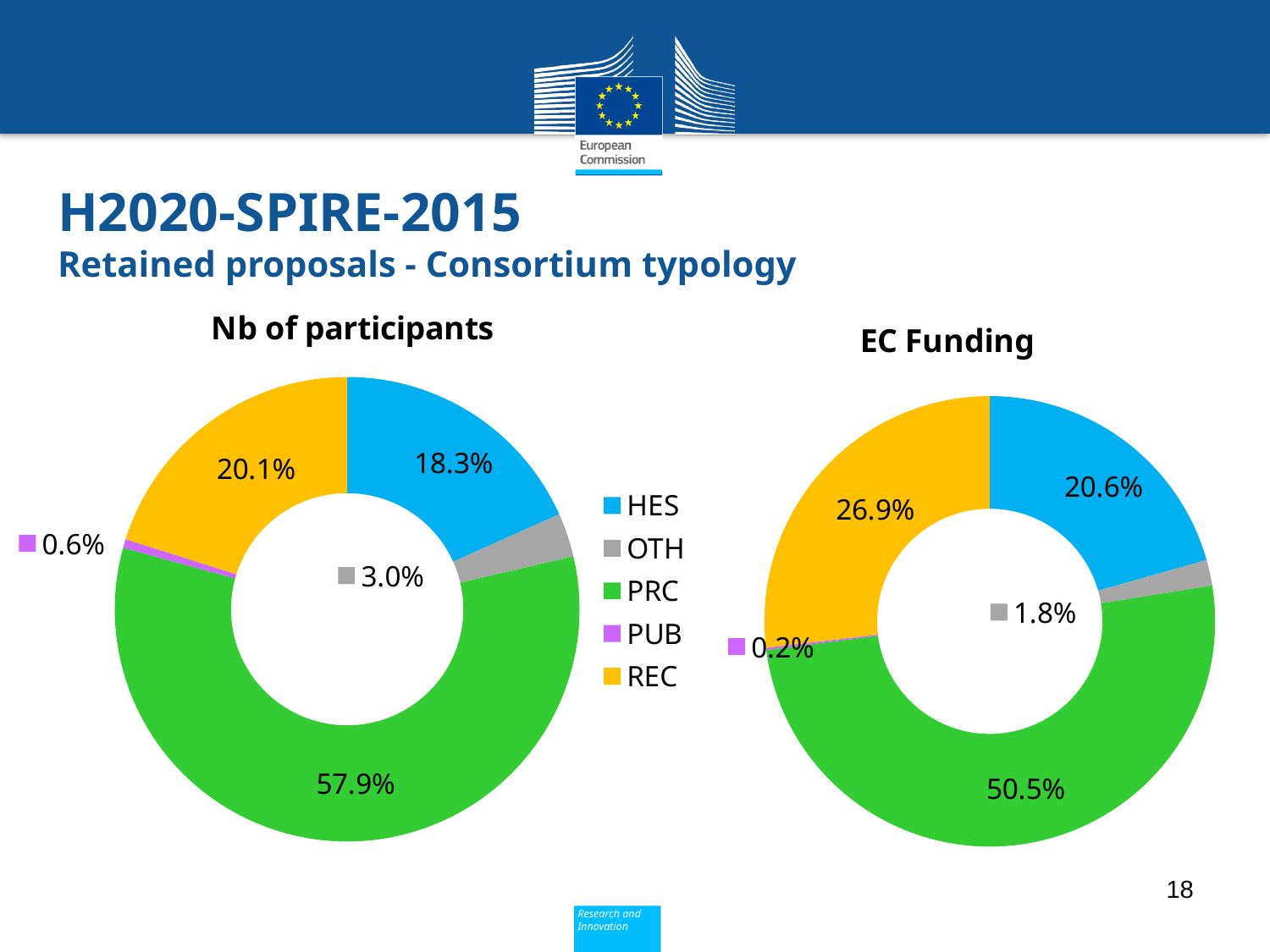
In the 'Nb of participants' chart, which category has the largest share? PRC How many categories does the legend list? 5 What kind of chart is the 'EC Funding' chart? doughnut (pie) chart In the 'EC Funding' chart, which category has the smallest share? PUB In the 'Nb of participants' chart, what is the share for PRC? 57.9% In the 'EC Funding' chart, what is the share for HES? 20.6% Which colour represents PRC in the legend? green In the 'EC Funding' chart, what is the share for REC? 26.9% In the 'EC Funding' chart, what is the difference between the PRC share and the REC share? 23.6% In the 'Nb of participants' chart, what is the share for OTH? 3.0% In the 'Nb of participants' chart, what is the share for PUB? 0.6% In the 'Nb of participants' chart, which is larger, the share for HES or the share for REC? REC